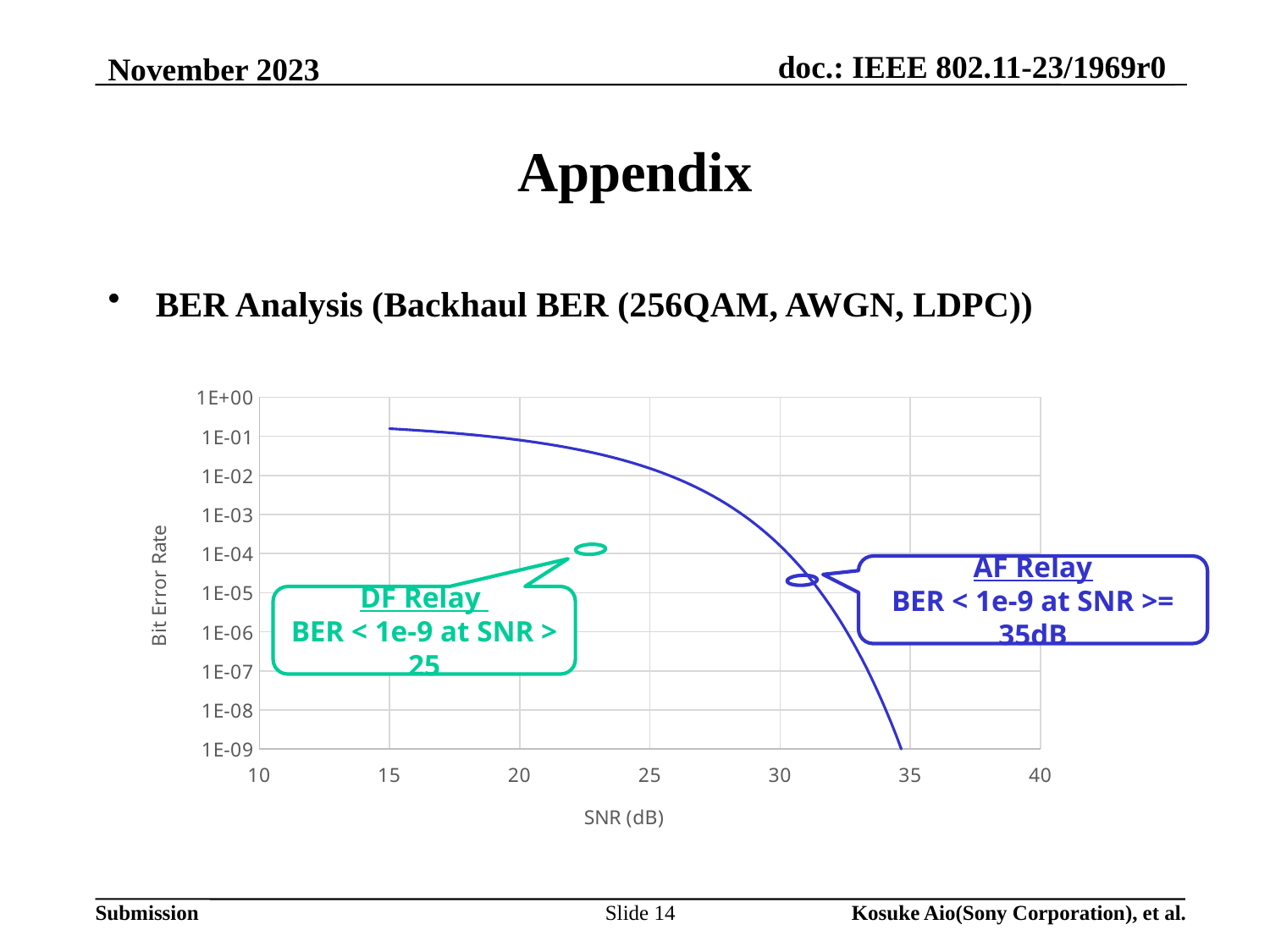
Is the bit error rate at SNR 15 dB greater or less than 1E-02? greater Is the bit error rate at SNR 20 dB greater or less than 1E-03? greater What is the label of the y axis? Bit Error Rate Is the bit error rate at SNR 25 dB greater or less than 1E-01? less Does the bit error rate rise or fall as SNR increases along the x axis? fall How many lines (series) are plotted on the chart? 1 What kind of chart is shown on the slide? line chart What is the label of the x axis? SNR (dB) Is the bit error rate higher at SNR 20 dB or at SNR 30 dB? 20 dB